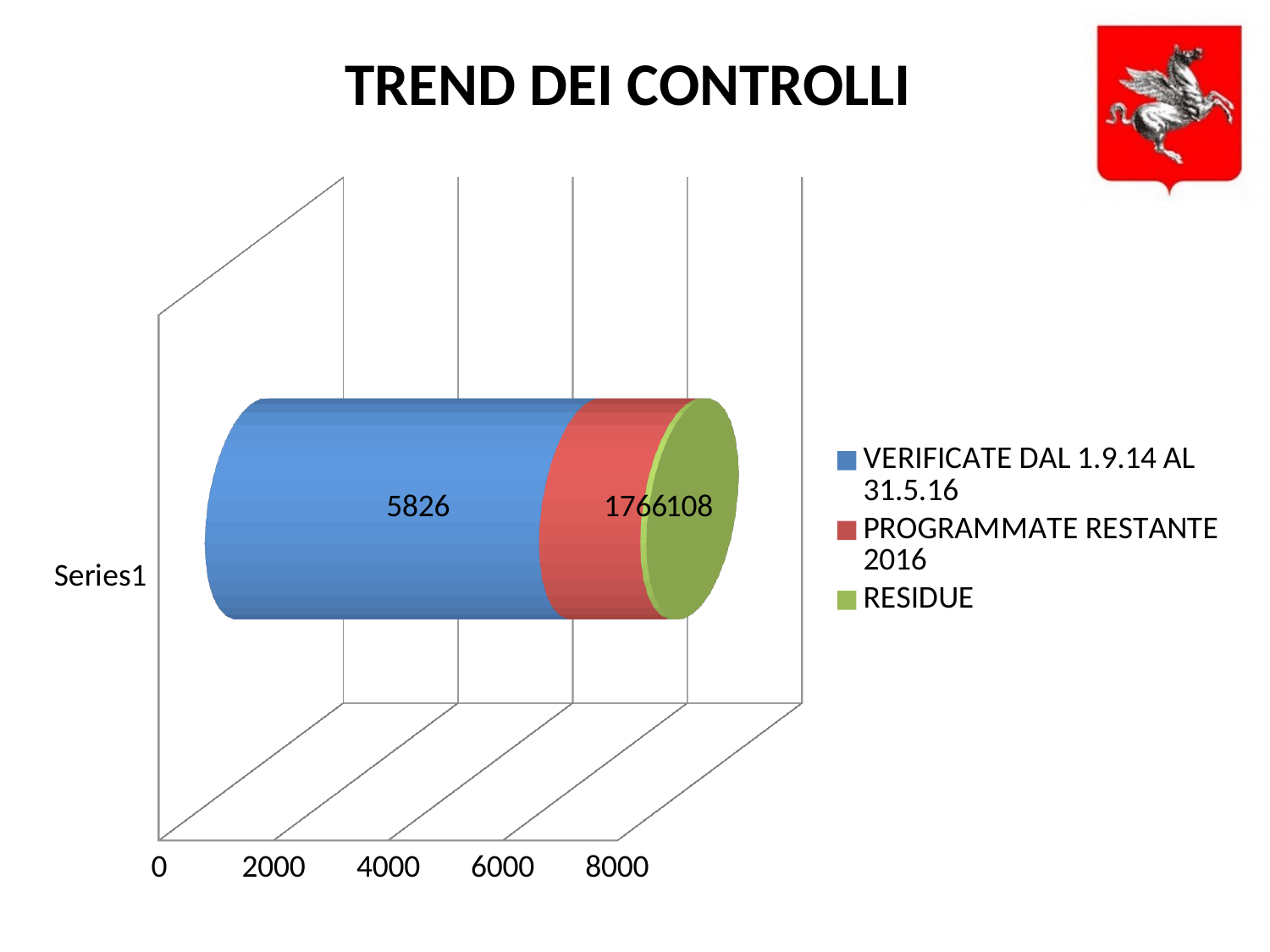
Which is larger, the value for VERIFICATE DAL 1.9.14 AL 31.5.16 or the value for PROGRAMMATE RESTANTE 2016? VERIFICATE DAL 1.9.14 AL 31.5.16 What is the label of the single category on the vertical axis? Series1 What is the title of the chart? TREND DEI CONTROLLI Which series has the largest value in the bar? VERIFICATE DAL 1.9.14 AL 31.5.16 Is the value for VERIFICATE DAL 1.9.14 AL 31.5.16 greater or less than 4000? greater How many series does the legend list? 3 Which series has the smallest value in the bar? RESIDUE What kind of chart is shown on the slide? Bar chart How many categories are plotted on the vertical axis? 1 What is the value for VERIFICATE DAL 1.9.14 AL 31.5.16? 5826 Is the value for PROGRAMMATE RESTANTE 2016 greater or less than 2000? less Which series is shown in green in the legend? RESIDUE